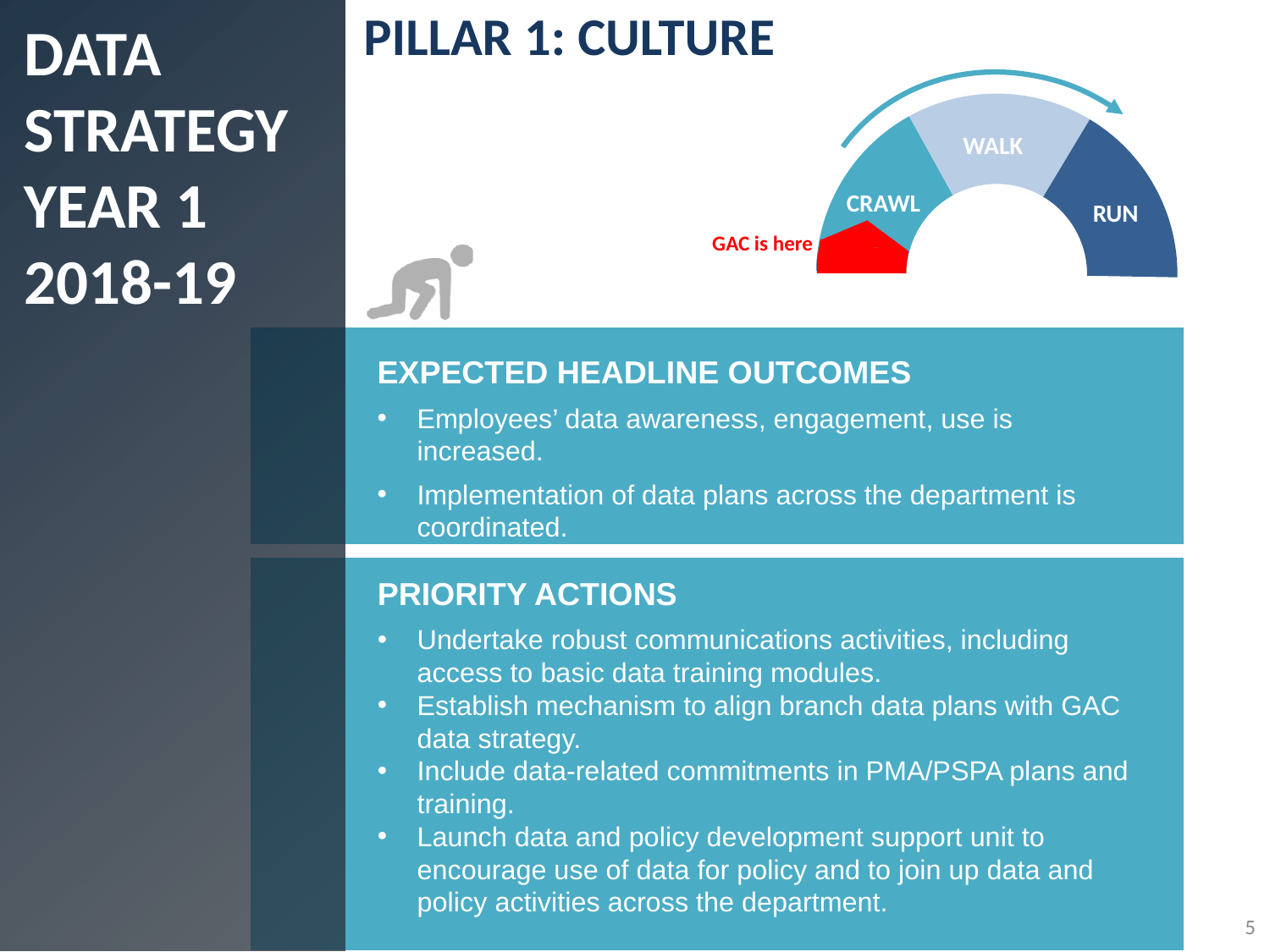
Which stage on the gauge does the red 'GAC is here' marker point to? CRAWL What are the three stage labels shown on the gauge, from left to right? CRAWL, WALK, RUN Which stage label is on the rightmost, dark blue segment of the gauge? RUN Which stage label sits in the middle segment of the gauge? WALK How many stages are labelled on the semicircular gauge at the top right of the slide? 3 What colour is the marker indicating where GAC currently is on the gauge? Red